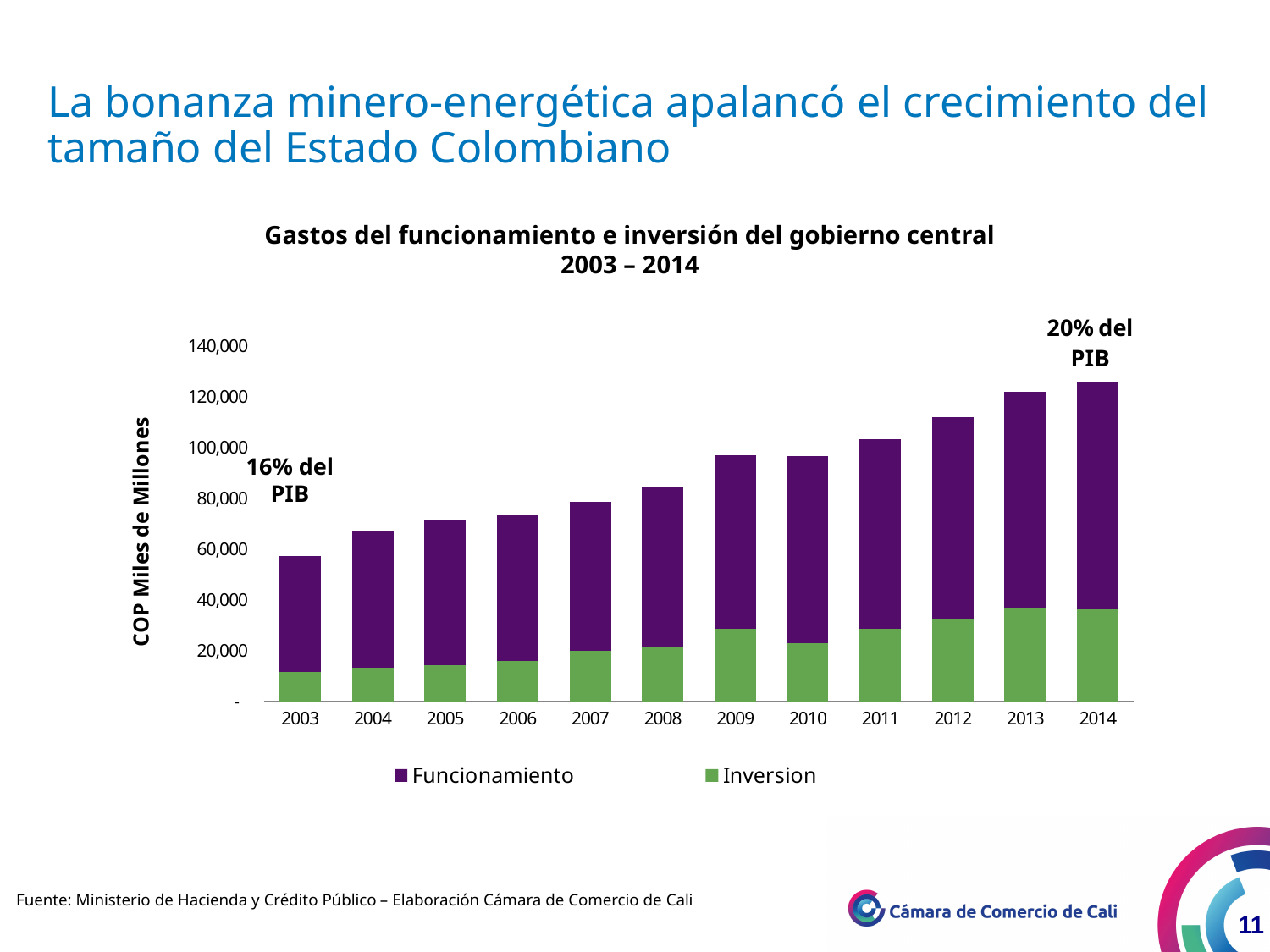
What is the label on the y axis of the chart? COP Miles de Millones Do total spending values generally rise or fall from 2003 to 2014? Rise Which year has the highest total government spending in the chart? 2014 Is the total spending for 2014 greater or less than 120,000? greater Is the Inversion value for 2014 greater or less than 40,000? less How many years are shown on the x axis of the chart? 12 Which year has the larger total spending, 2008 or 2009? 2009 According to the annotation on the chart, what share of GDP (PIB) did spending represent in 2014? 20% del PIB What kind of chart is shown on the slide? Stacked bar chart Is the total spending for 2003 greater or less than 60,000? less Which year has the lowest total government spending in the chart? 2003 How many series does the chart's legend list? 2